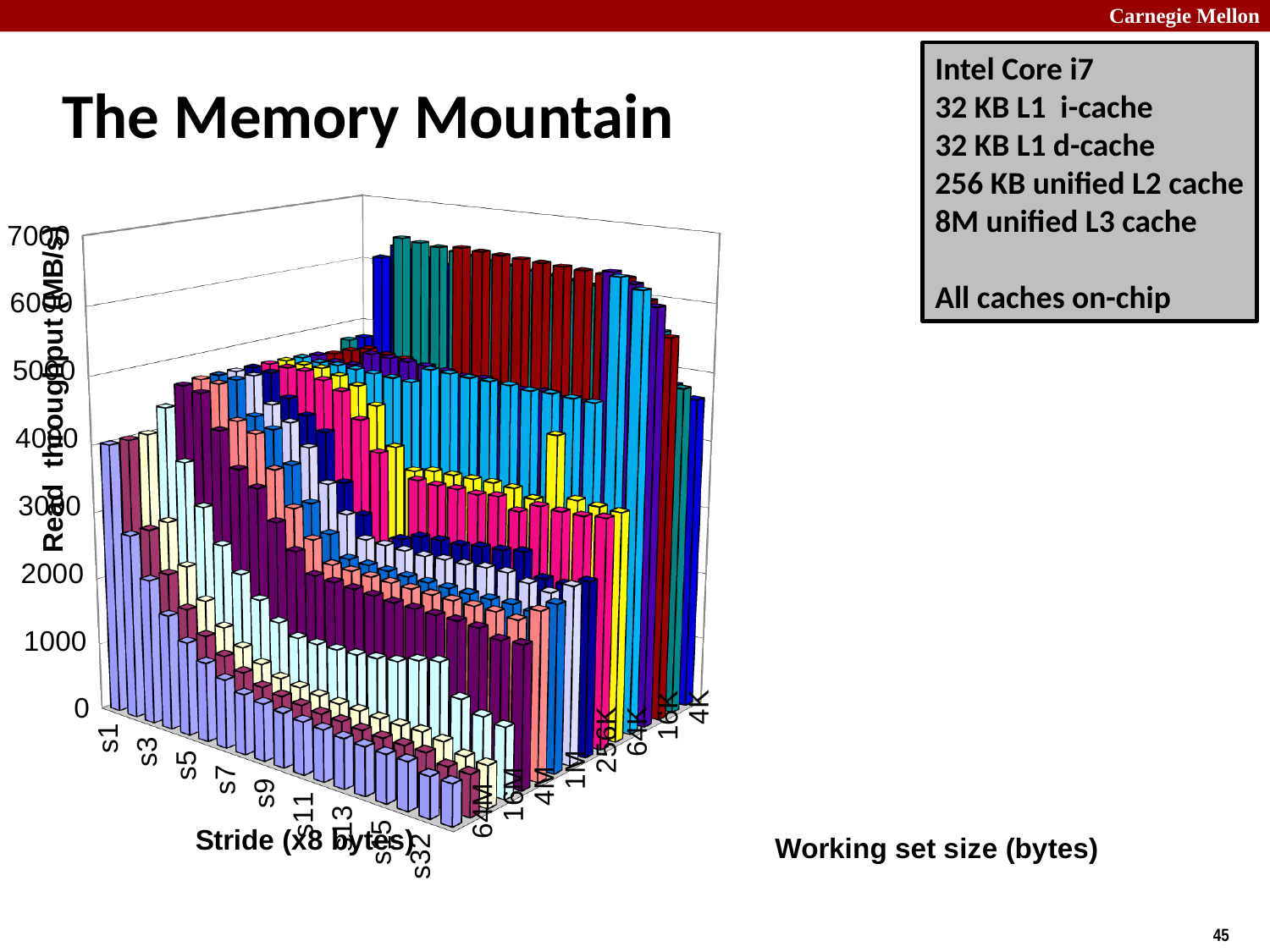
For stride s1, does read throughput rise or fall as the working set size decreases from 64M to 4K? rise What is the highest tick value shown on the vertical axis of the chart? 7000 How many working set size tick labels are shown along the Working set size (bytes) axis? 8 For a working set size of 64M, does read throughput rise or fall as the stride increases from s1 to s32? fall What is the title of the vertical axis of the chart? Read throughput (MB/s) Which stride has the higher read throughput at a working set size of 64M: s1 or s32? s1 What kind of chart is shown on the slide? bar chart Is the read throughput for stride s32 at a working set size of 64M greater or less than 2000? less How many stride tick labels are shown along the Stride (x8 bytes) axis? 9 Which working set size has the higher read throughput at stride s1: 64M or 4K? 4K